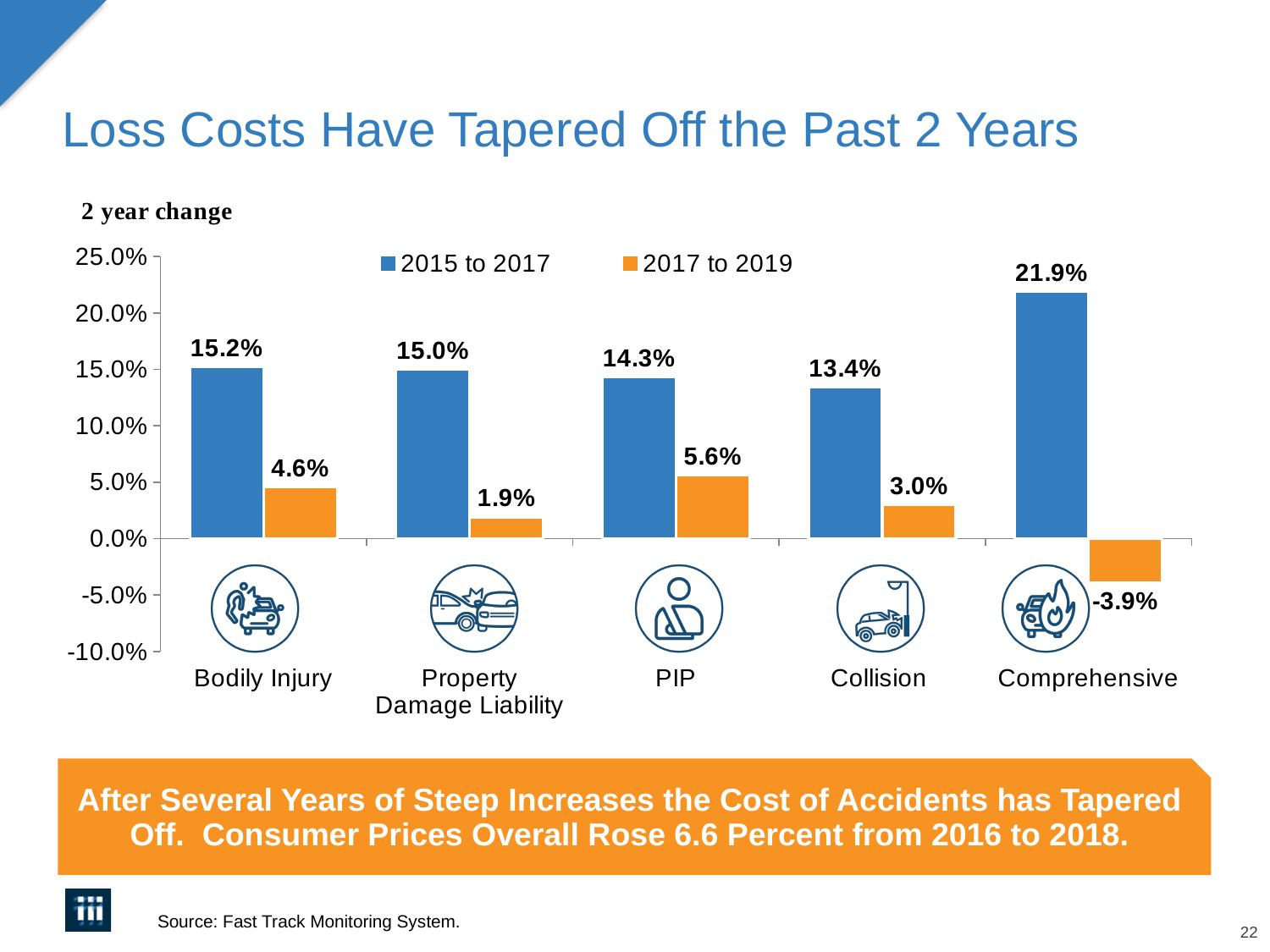
Which category has the highest 2015 to 2017 change? Comprehensive What is the 2015 to 2017 change for Collision? 13.4% How many categories are shown on the x axis? 5 How many series does the legend list? 2 Which series is shown in orange? 2017 to 2019 What is the 2015 to 2017 change for Bodily Injury? 15.2% What is the difference between the 2015 to 2017 and 2017 to 2019 changes for PIP? 8.7% Which category has the lowest 2017 to 2019 change? Comprehensive What is the 2017 to 2019 change for Comprehensive? -3.9% Which is larger, the 2017 to 2019 change for Bodily Injury or for Collision? Bodily Injury What is the 2017 to 2019 change for Property Damage Liability? 1.9% What kind of chart is shown on the slide? Bar chart